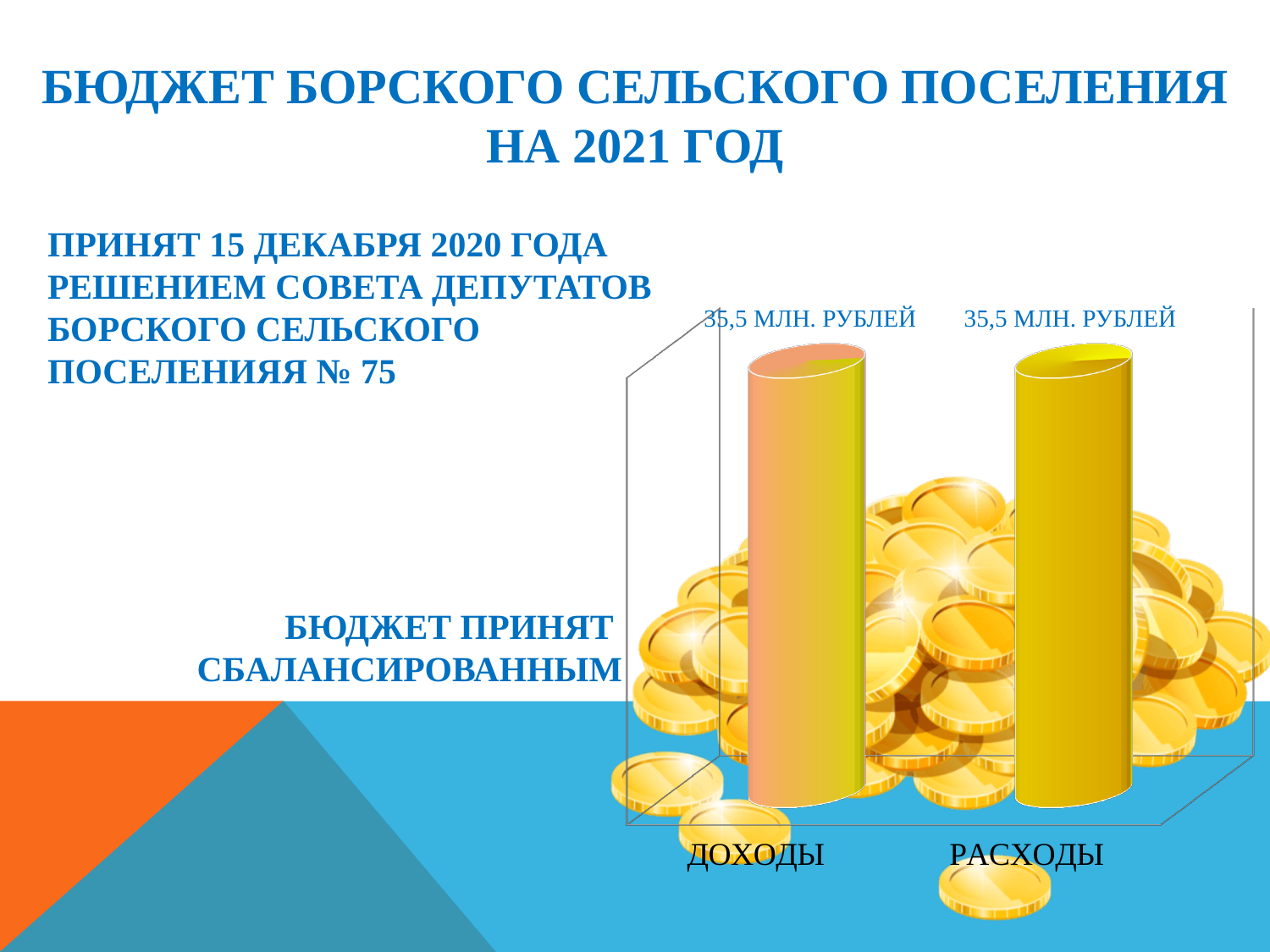
Are the values for ДОХОДЫ and РАСХОДЫ equal? yes What are the two category labels on the chart? ДОХОДЫ and РАСХОДЫ What is the difference between the values for ДОХОДЫ and РАСХОДЫ? 0 What is the value shown for РАСХОДЫ? 35,5 МЛН. РУБЛЕЙ How many categories are plotted in the chart? 2 What is the value shown for ДОХОДЫ? 35,5 МЛН. РУБЛЕЙ What kind of chart is shown on the slide? bar chart What colour is the bar for РАСХОДЫ? yellow What is the total of the values for ДОХОДЫ and РАСХОДЫ? 71 МЛН. РУБЛЕЙ